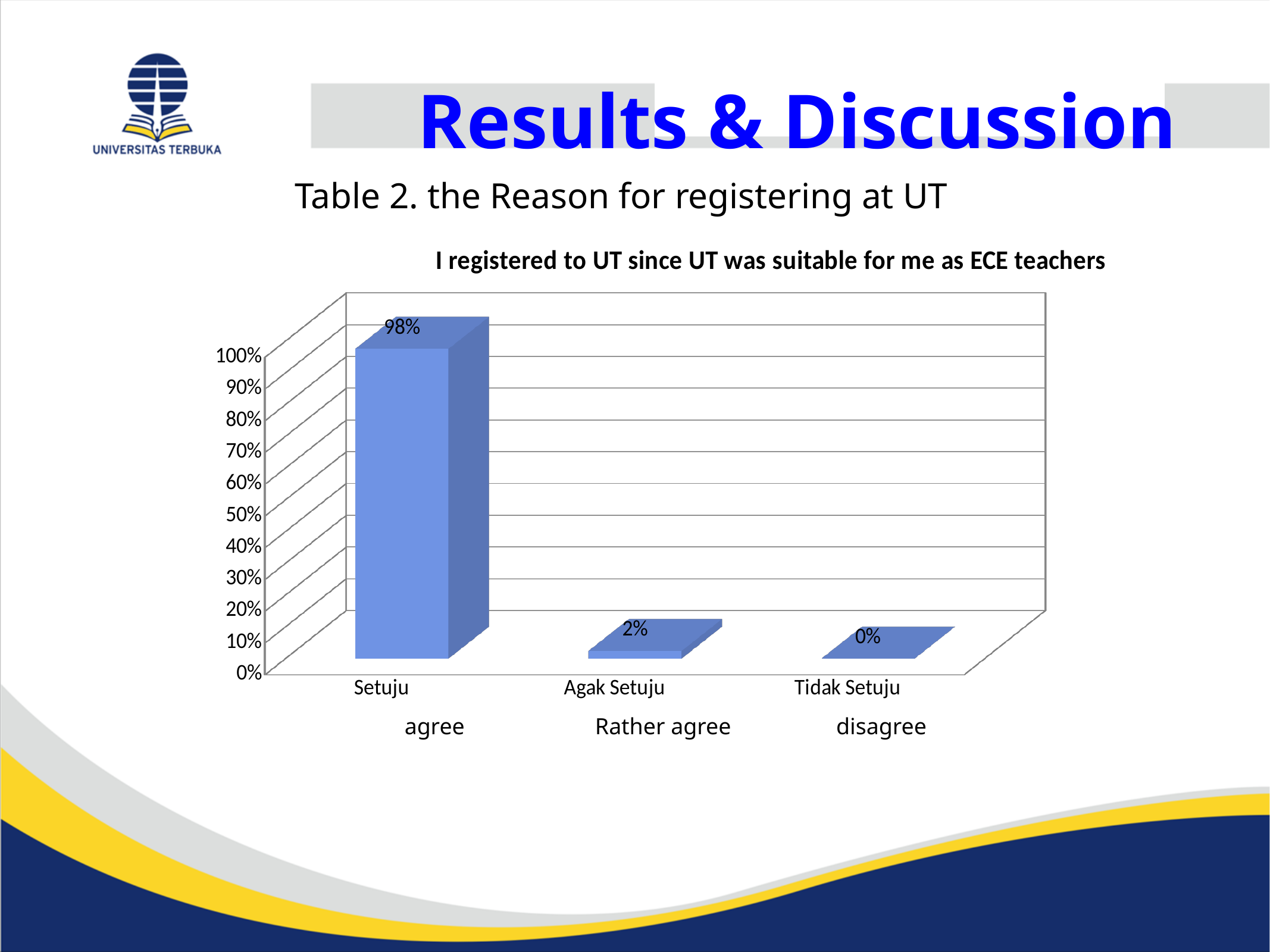
What is the title of the chart? I registered to UT since UT was suitable for me as ECE teachers What is the difference between the values for Setuju and Agak Setuju? 96% Which category has the highest value? Setuju What is the value for Agak Setuju (Rather agree)? 2% Is the value for Setuju greater or less than 90%? greater Which category has the lowest value? Tidak Setuju Do the values rise or fall from left to right along the x axis? fall What kind of chart is shown on the slide? bar chart How many categories are shown on the x axis? 3 What is the value for Setuju (agree)? 98% What is the value for Tidak Setuju (disagree)? 0% Which is larger, the value for Agak Setuju or the value for Tidak Setuju? Agak Setuju